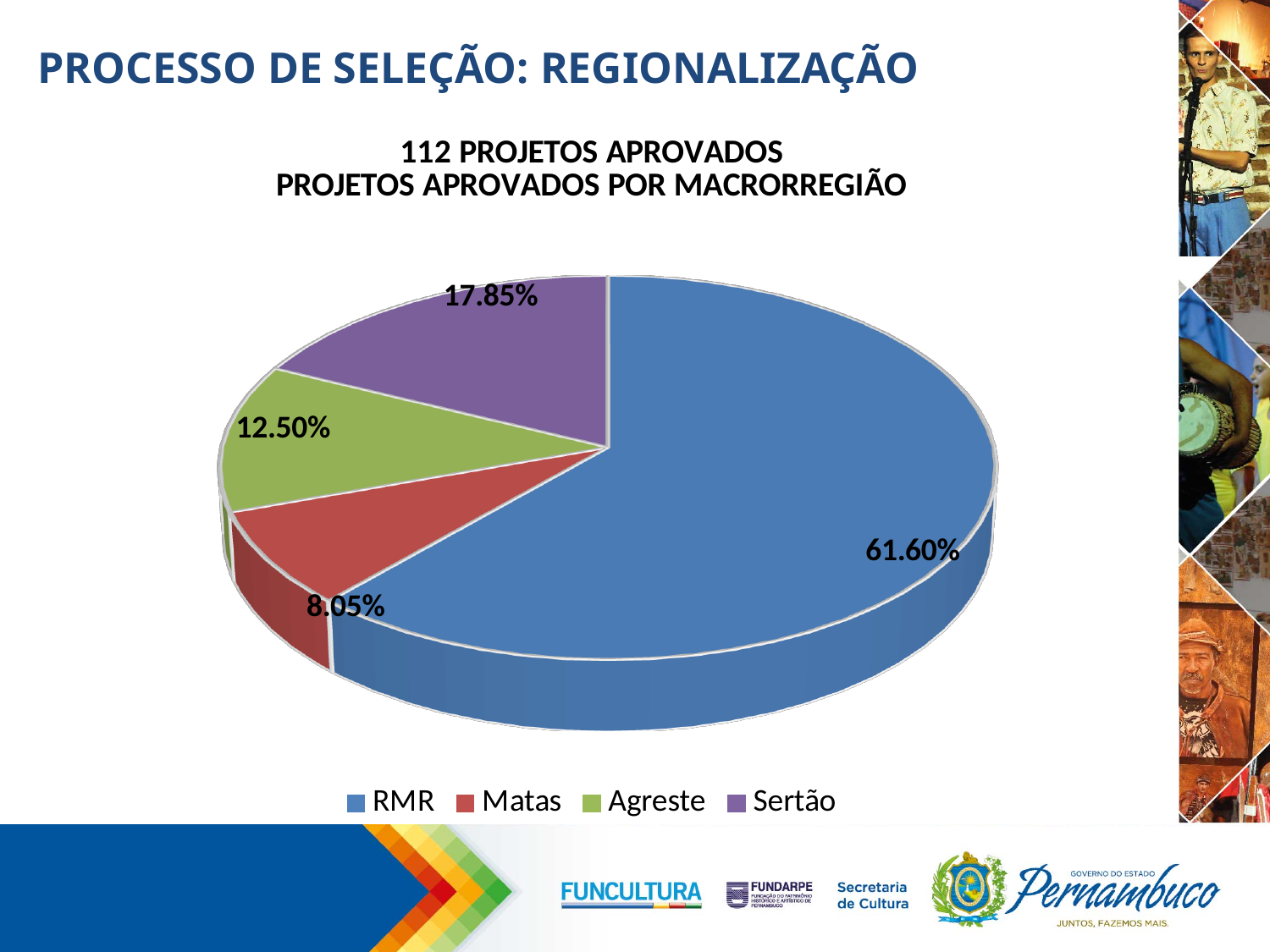
Which macro-region has the largest share of approved projects? RMR What kind of chart is shown on the slide? Pie chart What share of approved projects does Sertão account for? 17.85% What is the difference in percentage points between the RMR share and the Sertão share? 43.75 What is the difference in percentage points between the Agreste share and the Matas share? 4.45 Which macro-region has the smallest share of approved projects? Matas What share of approved projects does RMR account for? 61.60% Which has a larger share of approved projects, Agreste or Sertão? Sertão What share of approved projects does Agreste account for? 12.50% How many macro-regions are shown in the pie chart? 4 What share of approved projects does Matas account for? 8.05% Which colour represents Sertão in the pie chart? Purple